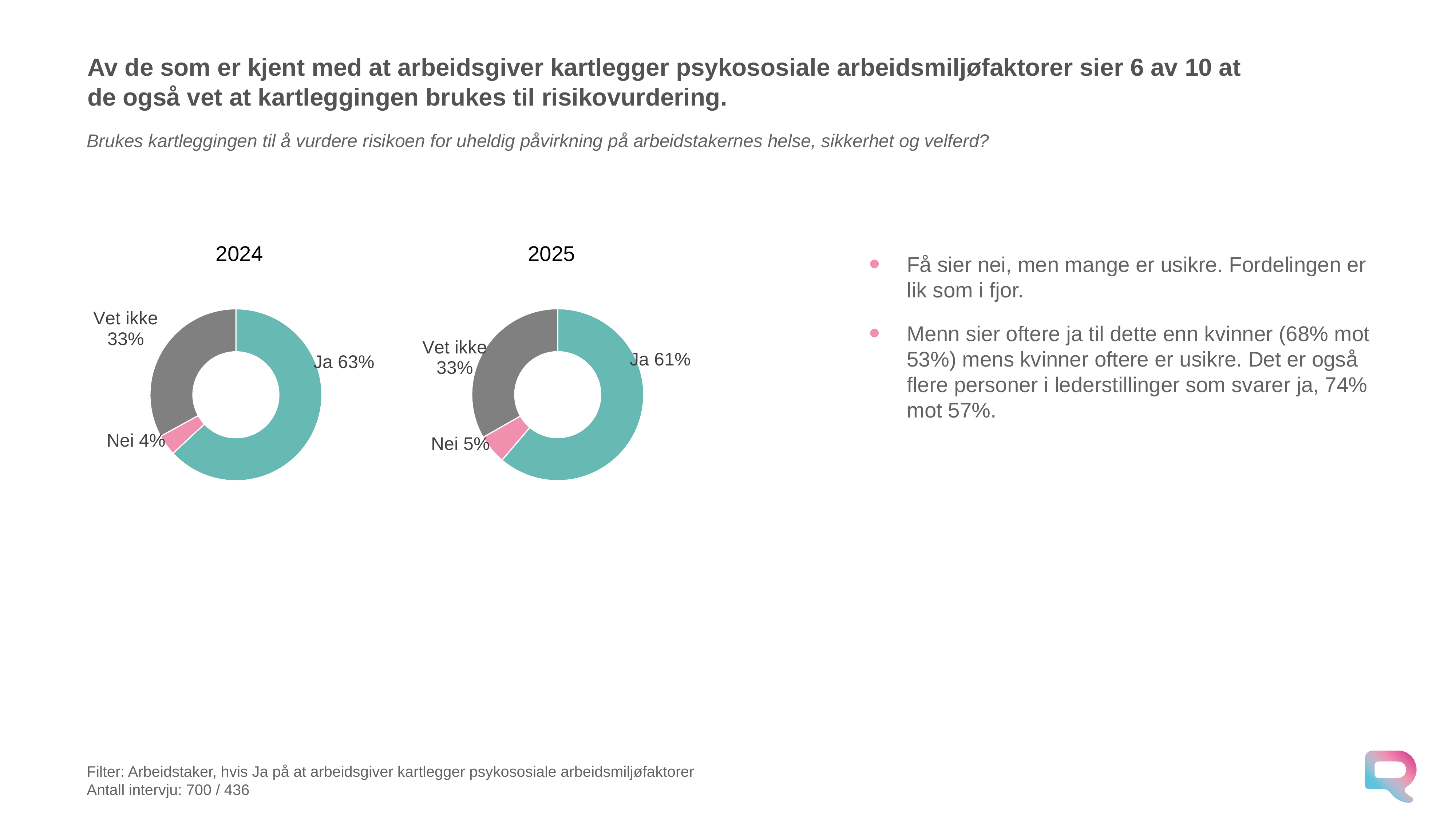
In the 2025 chart, what is the difference between the "Ja" share and the "Vet ikke" share? 28 percentage points In the 2025 chart, what is the value for "Vet ikke"? 33% What is the difference between the "Ja" share in 2024 and the "Ja" share in 2025? 2 percentage points In the 2024 chart, what share of respondents answered "Ja"? 63% In the 2025 chart, what share of respondents answered "Ja"? 61% In the 2024 chart, what is the value for "Nei"? 4% In the 2024 chart, which category has the largest share? Ja What type of chart is used to show the 2024 and 2025 results? Donut (pie) chart In the 2025 chart, which category has the smallest share? Nei How many categories does each donut chart show? 3 Is the "Nei" share larger in the 2024 chart or the 2025 chart? 2025 What colour is the "Ja" slice in the charts? Teal